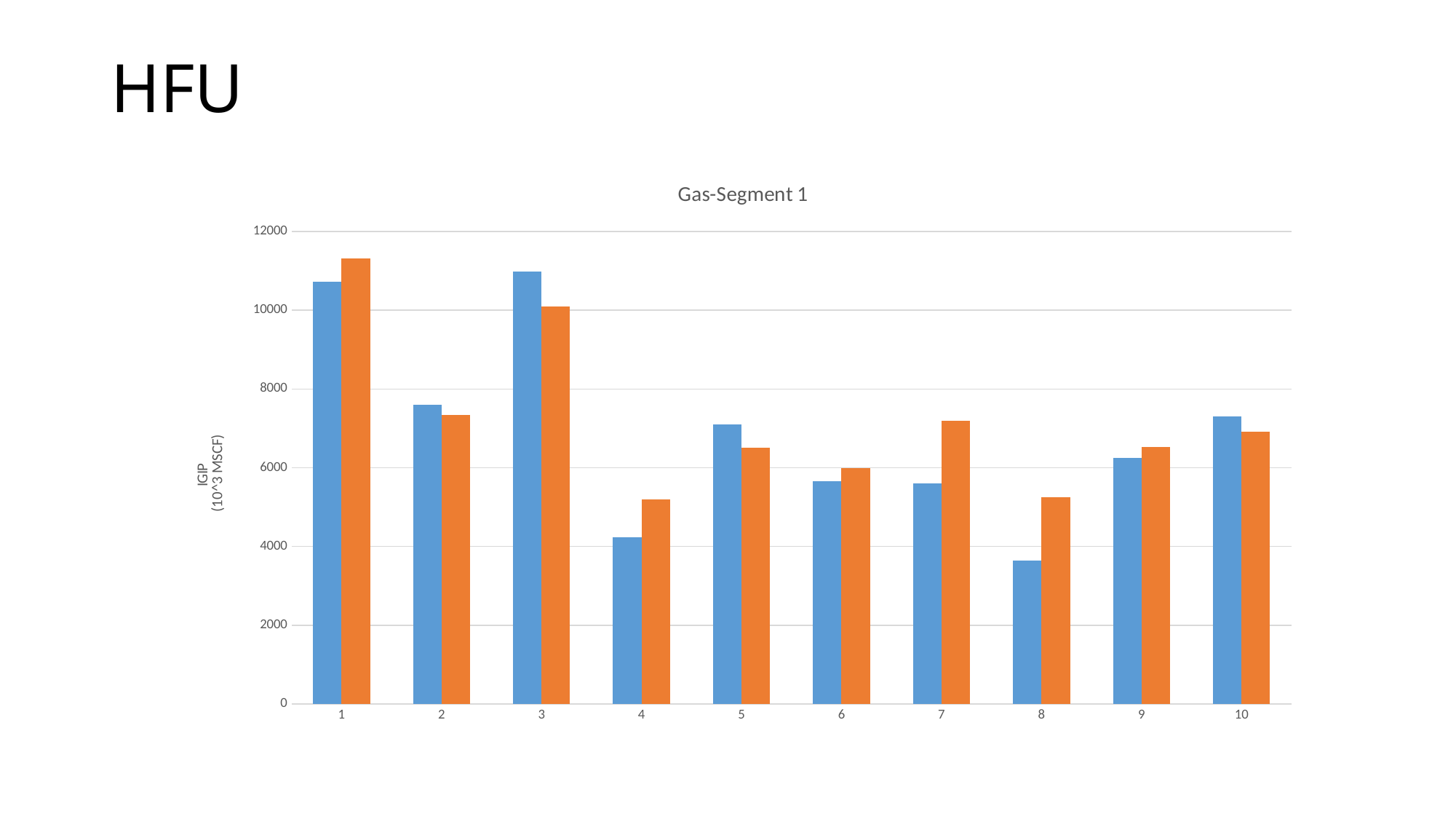
For category 7, which bar is taller, the blue one or the orange one? orange For category 3, which bar is taller, the blue one or the orange one? blue Is the value of the orange bar for category 7 greater or less than 6000? greater For which category is the blue bar the tallest? 3 What is the title of the chart? Gas-Segment 1 How many categories are shown on the x axis of the chart? 10 What kind of chart is shown on the slide? bar chart What is the label of the vertical axis of the chart? IGIP (10^3 MSCF) Is the value of the blue bar for category 8 greater or less than 4000? less For which category is the orange bar the tallest? 1 For which category is the blue bar the shortest? 8 Is the value of the orange bar for category 1 greater or less than 10000? greater